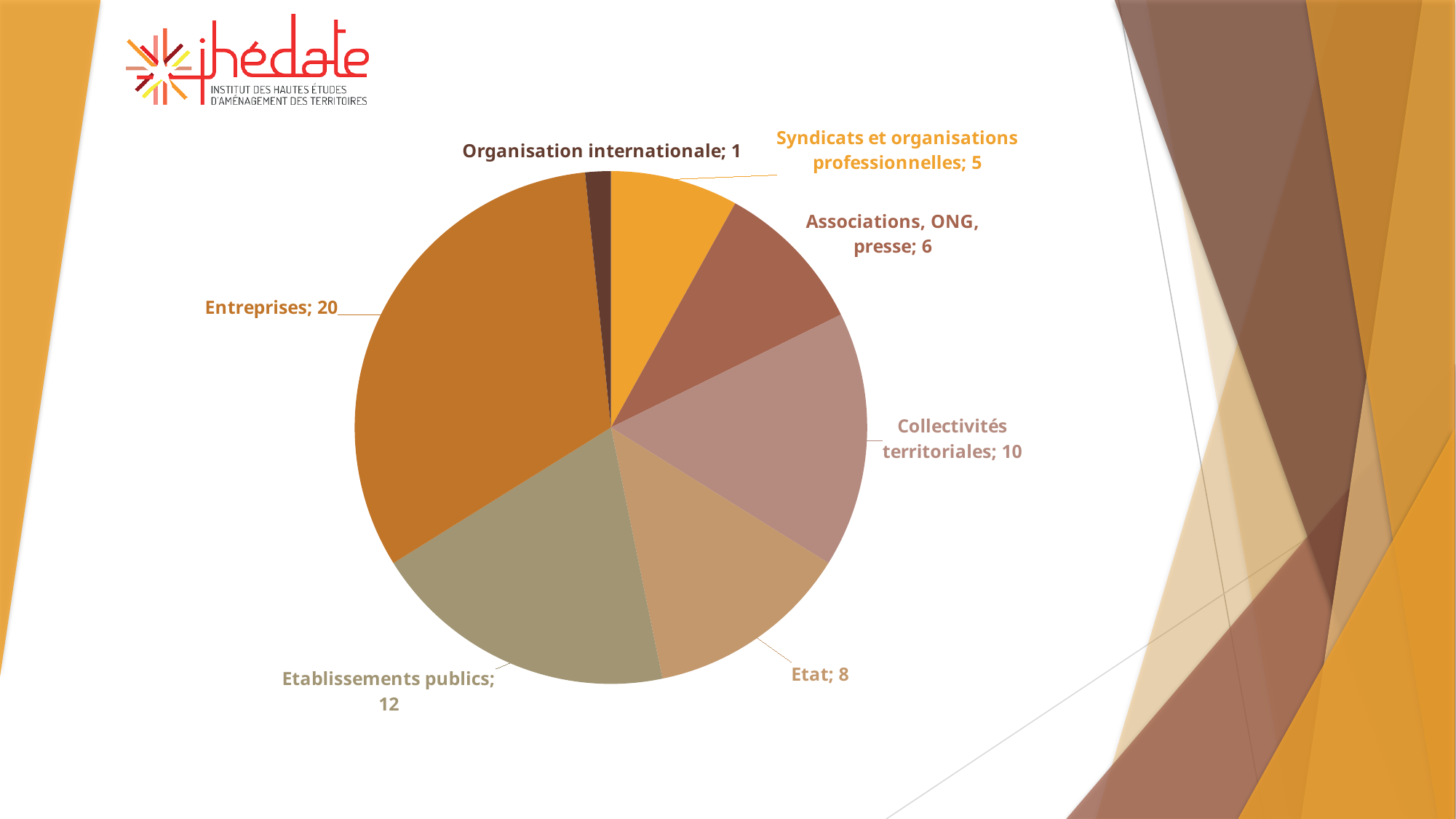
What is the value for Entreprises? 20 What is the value for Organisation internationale? 1 What kind of chart is shown on the slide? Pie chart What is the difference between the values for Collectivités territoriales and Syndicats et organisations professionnelles? 5 What is the value for Etablissements publics? 12 Which category has the smallest slice of the pie? Organisation internationale What is the value for Collectivités territoriales? 10 What is the total of all the values shown in the pie chart? 62 Which is larger, the value for Etat or the value for Associations, ONG, presse? Etat Which category has the largest slice of the pie? Entreprises How many slices does the pie chart have? 7 What is the difference between the values for Entreprises and Etablissements publics? 8